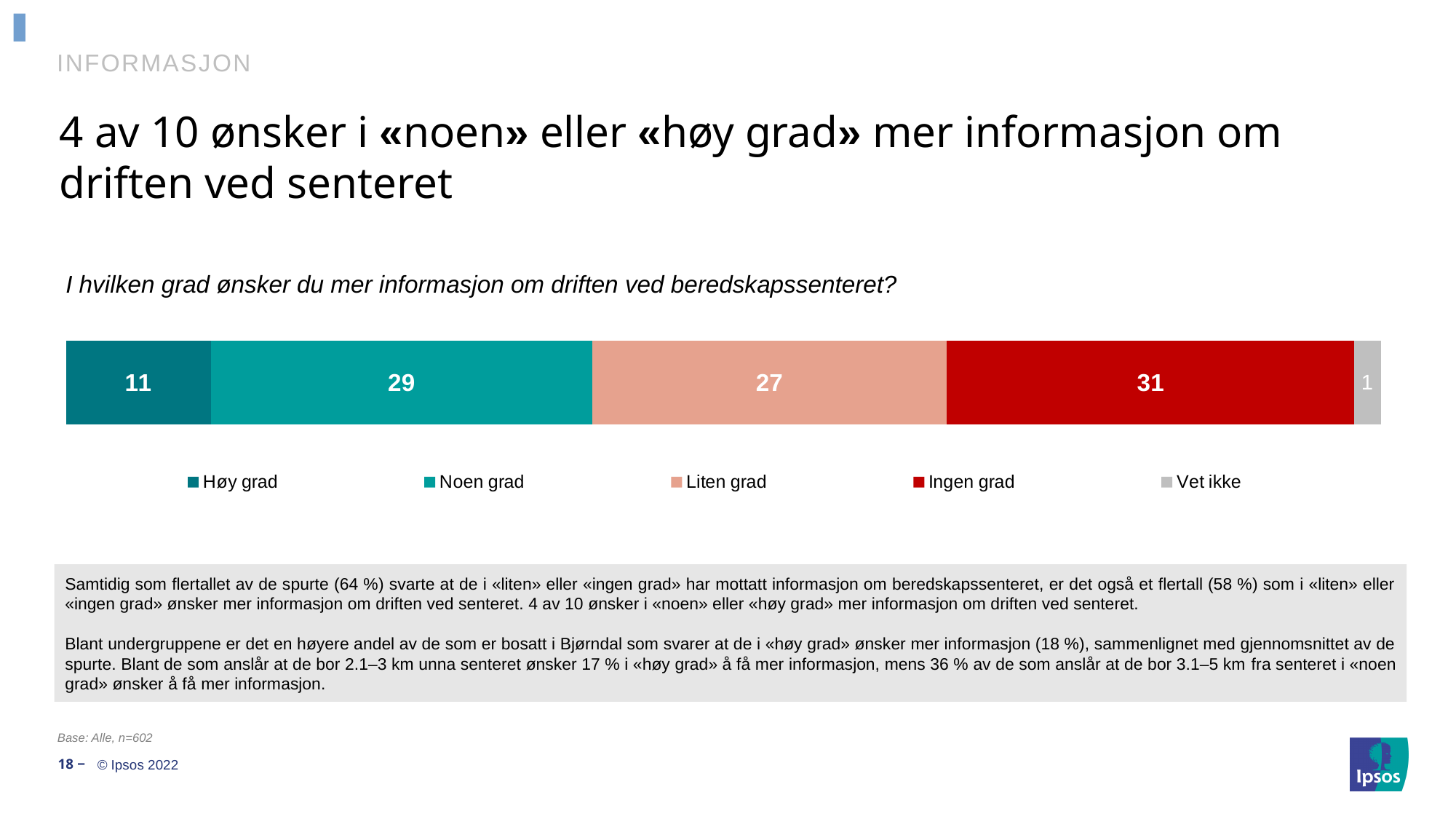
Which category has the highest value? Ingen grad What is the value for "Ingen grad"? 31 What is the value for "Noen grad"? 29 What is the value for "Høy grad"? 11 What is the value for "Liten grad"? 27 Which is larger, the value for "Noen grad" or the value for "Liten grad"? Noen grad What is the value for "Vet ikke"? 1 Which category has the lowest value? Vet ikke How many series does the legend list? 5 What is the total of the stacked bar? 99 What is the difference between the values for "Ingen grad" and "Høy grad"? 20 What kind of chart is shown on the slide? Stacked bar chart